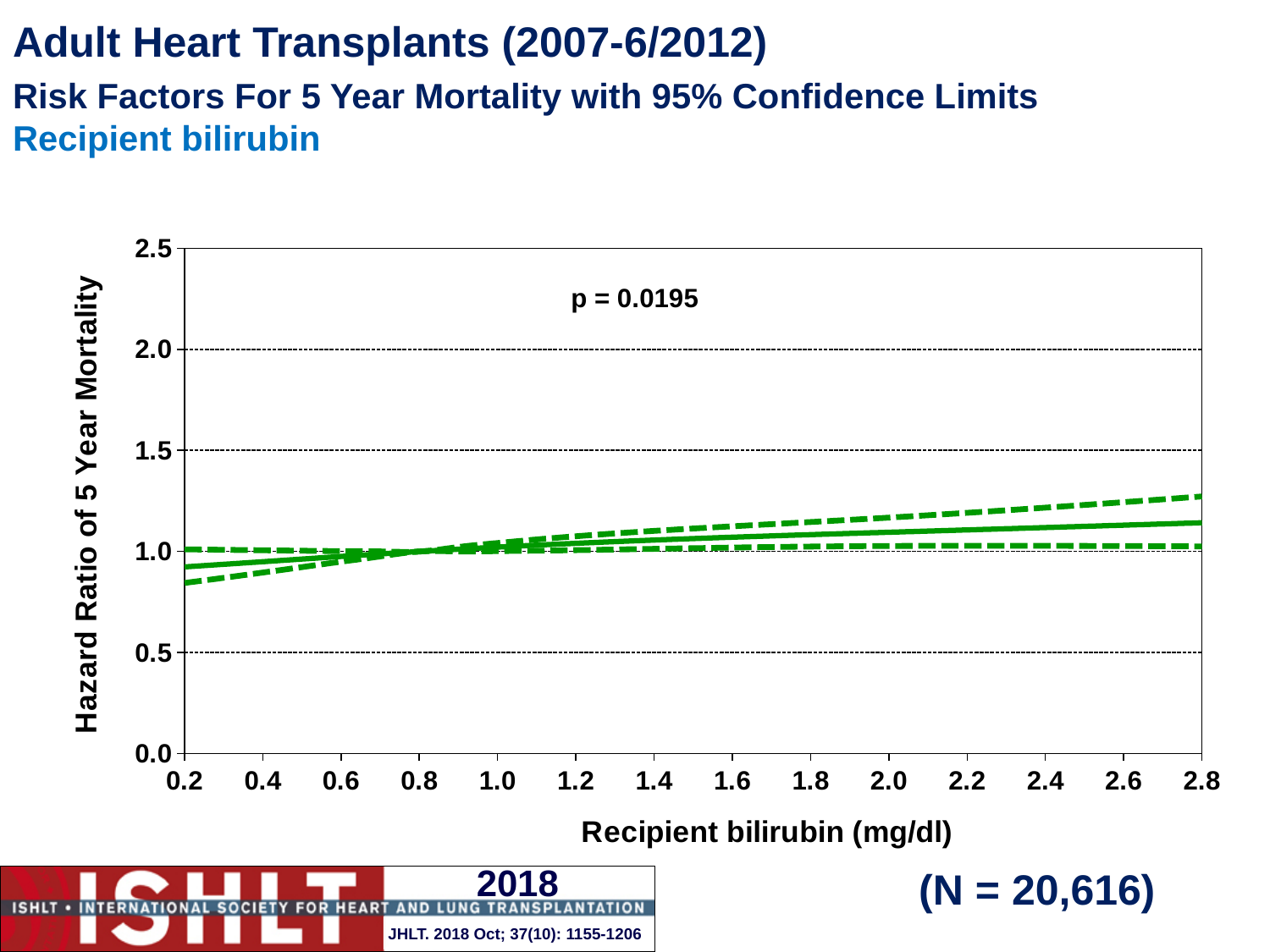
Is the hazard ratio (solid line) at a recipient bilirubin of 0.2 mg/dl greater or less than 1.5? less Is the hazard ratio (solid line) at a recipient bilirubin of 2.8 mg/dl greater or less than 1.0? greater What kind of chart is shown on the slide? line chart What sample size (N) is shown on the slide? N = 20,616 What p-value is printed on the chart? p = 0.0195 Does the hazard ratio of 5 year mortality rise or fall as recipient bilirubin increases from 0.2 to 2.8 mg/dl? rise Is the upper 95% confidence limit at a recipient bilirubin of 2.8 mg/dl greater or less than 1.0? greater How many lines are plotted on the chart (the hazard ratio plus its confidence limits)? 3